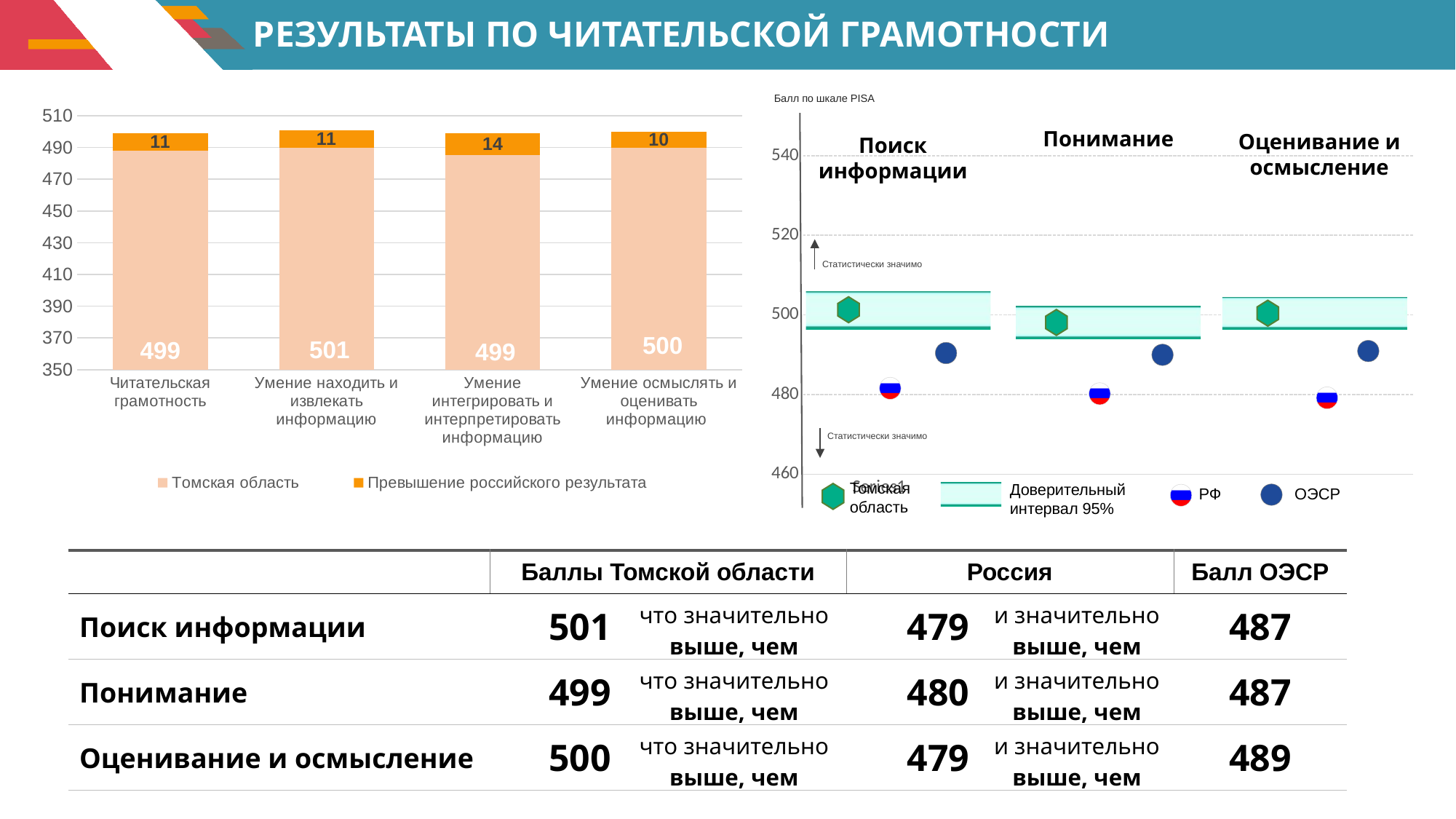
On the left bar chart, which category has the lowest value of Превышение российского результата? Умение осмыслять и оценивать информацию On the right chart, how many series does the legend list? 4 On the right chart, is the value for РФ for Поиск информации greater or less than 500? less On the left bar chart, which category has the highest value of Превышение российского результата? Умение интегрировать и интерпретировать информацию On the right chart, is the value for ОЭСР for Понимание greater or less than 500? less What kind of chart is the chart on the left of the slide? Bar chart On the left bar chart, what is the value of Превышение российского результата for Умение интегрировать и интерпретировать информацию? 14 On the left bar chart, how many series does the legend list? 2 On the left bar chart, what is the value for Томская область for Читательская грамотность? 499 On the left bar chart, what is the value for Томская область for Умение находить и извлекать информацию? 501 On the left bar chart, how many categories are shown on the x axis? 4 On the left bar chart, what is the difference between the Превышение российского результата values for Умение интегрировать и интерпретировать информацию and Умение осмыслять и оценивать информацию? 4